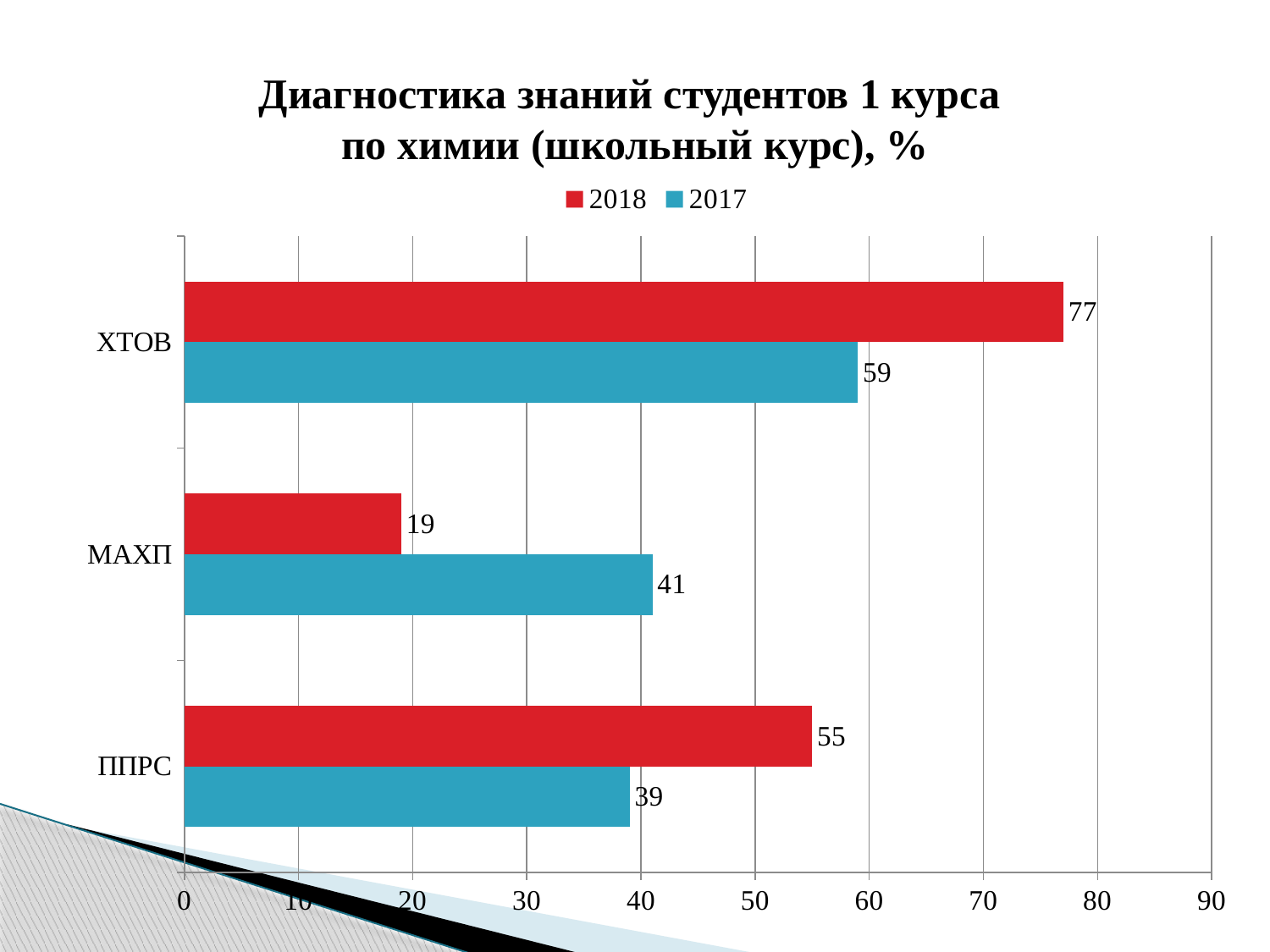
Which category has the lowest 2018 value? МАХП Which colour represents the 2017 series? blue What is the difference between the 2018 and 2017 values for ХТОВ? 18 What is the 2018 value for ХТОВ? 77 Which is larger for ППРС, the 2018 value or the 2017 value? 2018 What is the difference between the 2017 and 2018 values for МАХП? 22 What kind of chart is shown on the slide? bar chart What is the 2017 value for МАХП? 41 Which category has the highest 2018 value? ХТОВ How many categories are shown on the chart? 3 How many series does the legend list? 2 What is the 2017 value for ППРС? 39